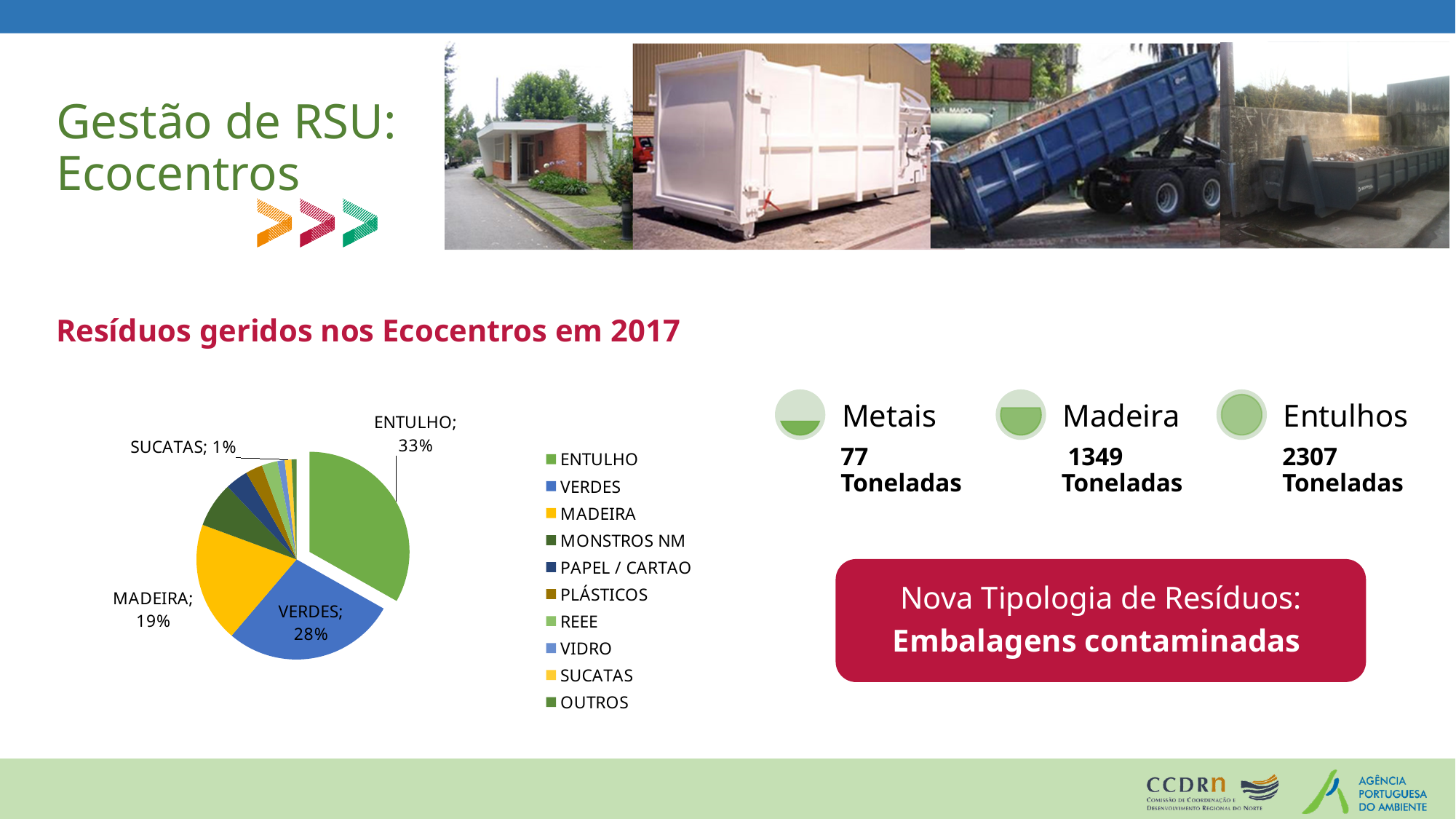
What share of the pie does MADEIRA represent? 19% What is the difference in percentage points between the ENTULHO and MADEIRA slices? 14 What is the title above the pie chart? Resíduos geridos nos Ecocentros em 2017 What share of the pie does VERDES represent? 28% What share of the pie does ENTULHO represent? 33% What is the difference in percentage points between the ENTULHO and VERDES slices? 5 What kind of chart is shown on the slide? pie chart How many categories does the legend of the pie chart list? 10 Which category has the largest slice of the pie? ENTULHO Which slice is larger, VERDES or MADEIRA? VERDES What colour is the ENTULHO slice in the pie chart? green